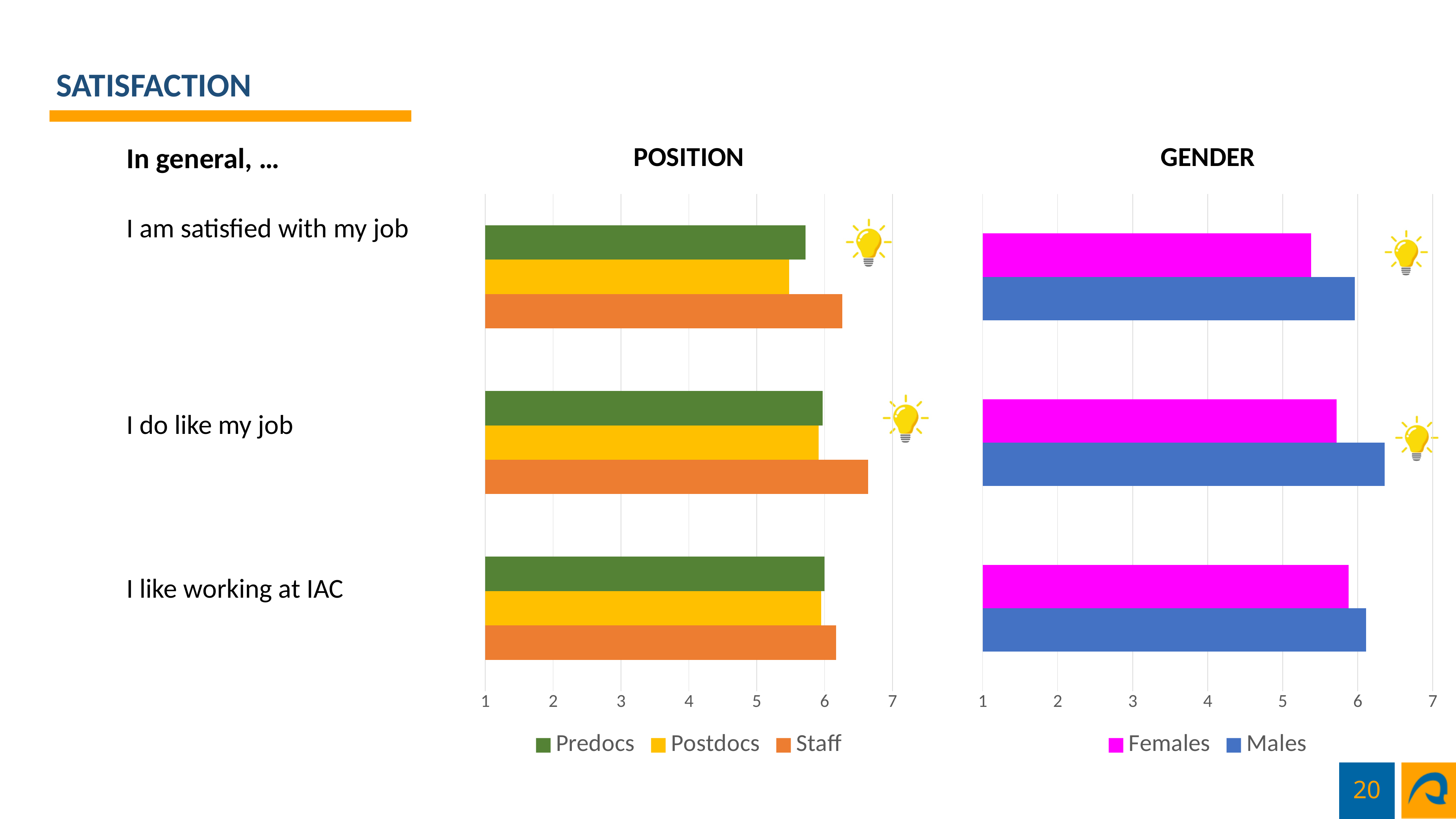
How many series does the legend of the POSITION chart list? 3 In the POSITION chart, is the Postdocs value for 'I am satisfied with my job' greater or less than 6? less In the POSITION chart, which series has the highest value for 'I am satisfied with my job'? Staff In the POSITION chart, is the Staff value for 'I do like my job' greater or less than 6? greater Which series in the GENDER chart is shown in magenta? Females In the GENDER chart, is the Females value for 'I am satisfied with my job' greater or less than 6? less In the POSITION chart, which series has the lowest value for 'I am satisfied with my job'? Postdocs How many series does the legend of the GENDER chart list? 2 In the GENDER chart, which is larger for 'I do like my job': Females or Males? Males How many statement categories are plotted in the GENDER chart? 3 What kind of chart is the POSITION chart? bar chart